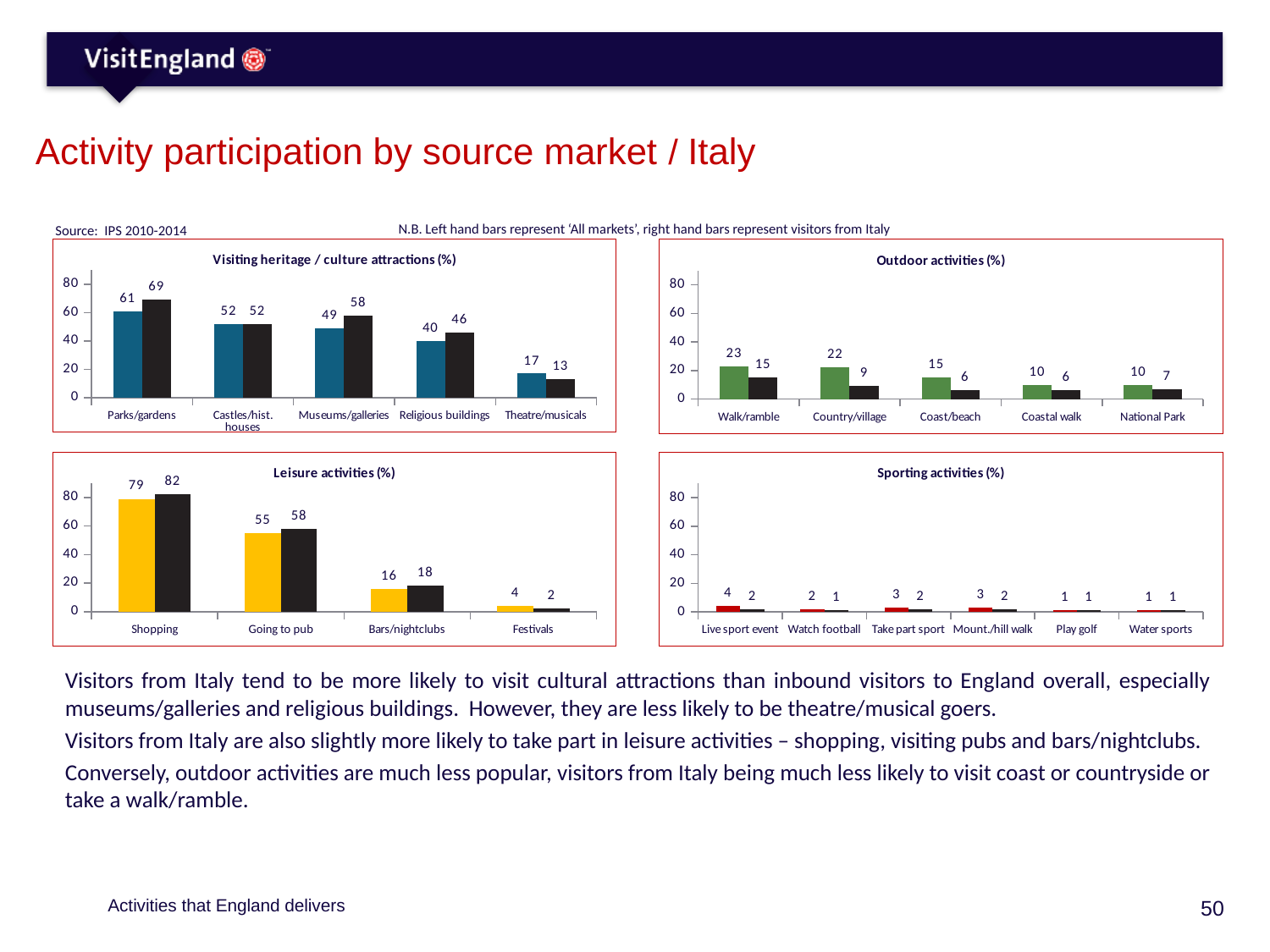
In the 'Visiting heritage / culture attractions (%)' chart, what is the difference between the Italy value and the All markets value for Parks/gardens? 8 In the 'Sporting activities (%)' chart, how many activity categories are shown on the x axis? 6 In the 'Visiting heritage / culture attractions (%)' chart, which category has the highest value for visitors from Italy? Parks/gardens In the 'Leisure activities (%)' chart, which is larger for Going to pub: the All markets value or the Italy value? Italy (58) In the 'Sporting activities (%)' chart, what is the 'All markets' value for Live sport event? 4 What type of chart is the 'Leisure activities (%)' chart? Bar chart In the 'Outdoor activities (%)' chart, how many activity categories are shown on the x axis? 5 In the 'Leisure activities (%)' chart, what is the value for visitors from Italy for Shopping? 82 In the 'Visiting heritage / culture attractions (%)' chart, what is the 'All markets' (left hand bar) value for Theatre/musicals? 17 In the 'Outdoor activities (%)' chart, which category has the lowest 'All markets' value? Coastal walk and National Park (both 10) In the 'Visiting heritage / culture attractions (%)' chart, what is the value for visitors from Italy (right hand bar) for Museums/galleries? 58 In the 'Outdoor activities (%)' chart, what is the value for visitors from Italy for Country/village? 9